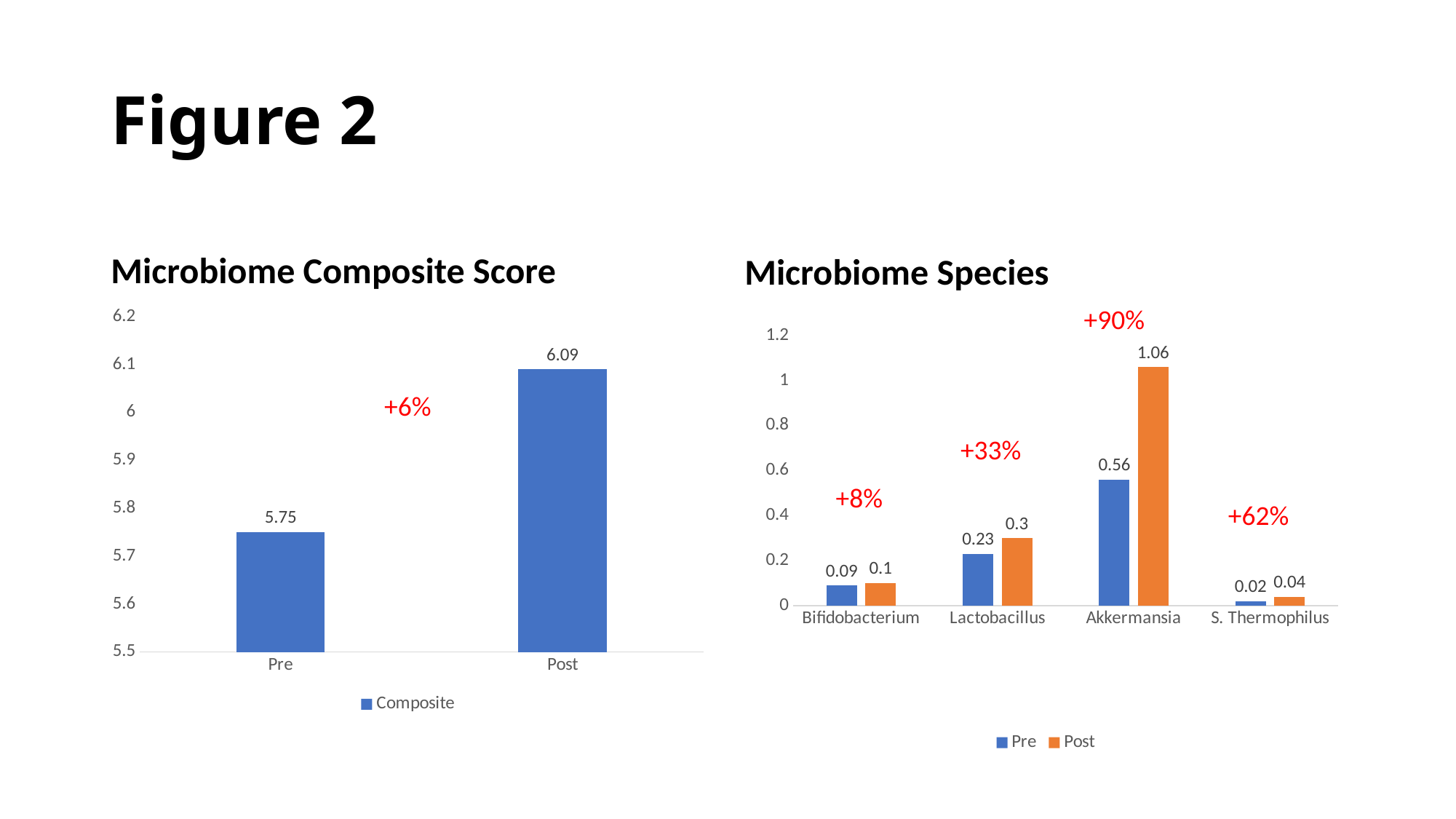
In the Microbiome Species chart, what is the difference between the Post and Pre values for Akkermansia? 0.5 In the Microbiome Composite Score chart, what percentage change is annotated between Pre and Post? +6% In the Microbiome Species chart, how many species categories are shown? 4 In the Microbiome Composite Score chart, what is the value for Pre? 5.75 In the Microbiome Species chart, what is the Pre value for Lactobacillus? 0.23 In the Microbiome Species chart, how many series does the legend list? 2 In the Microbiome Species chart, which species has the highest Post value? Akkermansia In the Microbiome Composite Score chart, what is the value for Post? 6.09 In the Microbiome Species chart, what is the Post value for Akkermansia? 1.06 What kind of chart is the Microbiome Species chart? Bar chart In the Microbiome Composite Score chart, what is the difference between the Post and Pre values? 0.34 In the Microbiome Species chart, which species has the lowest Pre value? S. Thermophilus